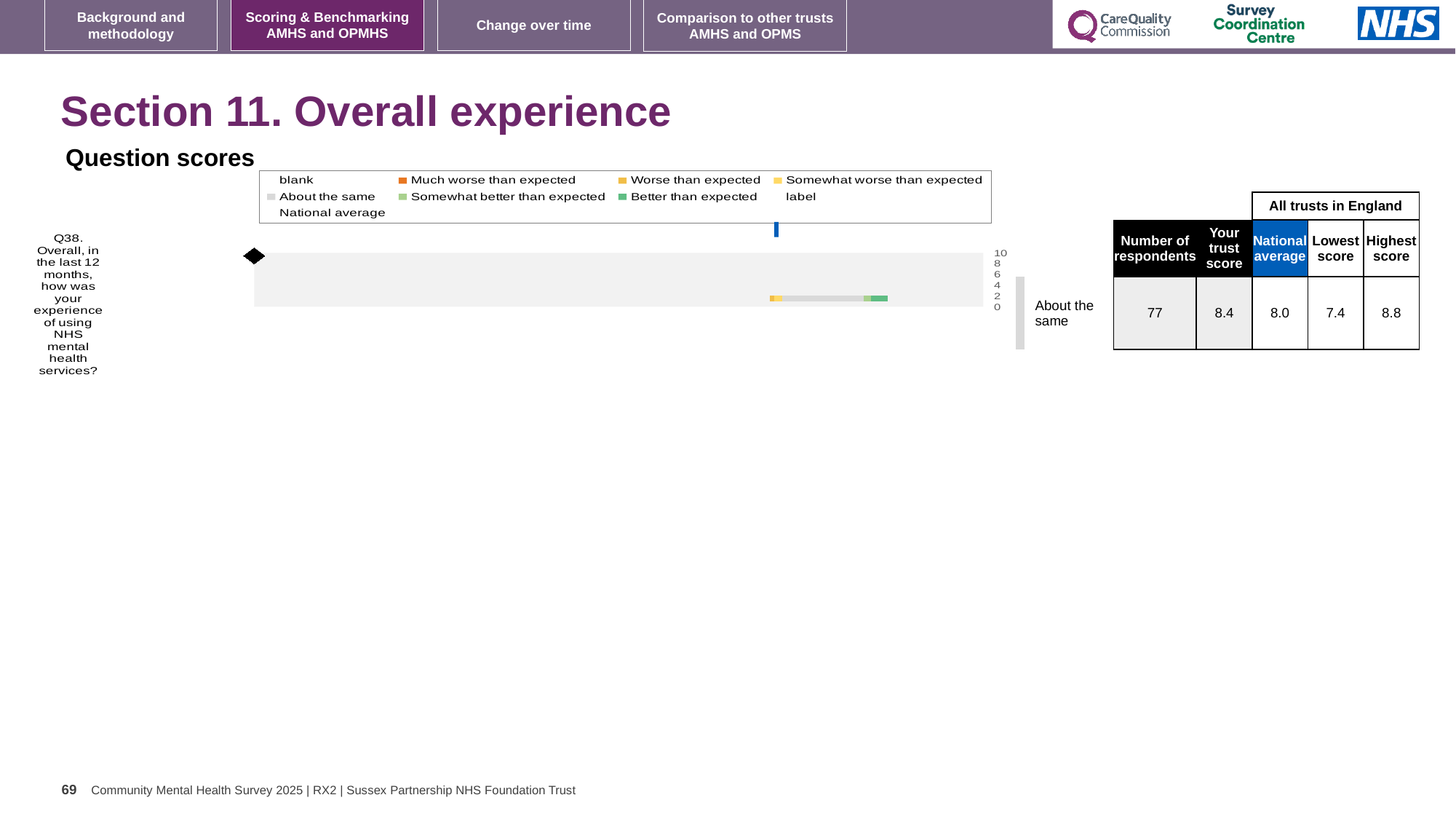
What is the national average for Q38 in the table next to the chart? 8.0 Which question is plotted in the Question scores chart? Q38. Overall, in the last 12 months, how was your experience of using NHS mental health services? What is the lowest score among all trusts in England for Q38? 7.4 For Q38, which is larger: the trust's score or the national average? the trust's score For Q38, what is the difference between the highest score and the lowest score among all trusts in England? 1.4 What is the trust's score for Q38 in the table next to the chart? 8.4 What is the highest score among all trusts in England for Q38? 8.8 What kind of chart is shown under 'Question scores'? bar chart What benchmark category label is shown to the right of the bar for Q38? About the same How many survey questions are plotted in the Question scores chart? 1 For Q38, what is the difference between the trust's score and the national average? 0.4 How many respondents answered Q38? 77